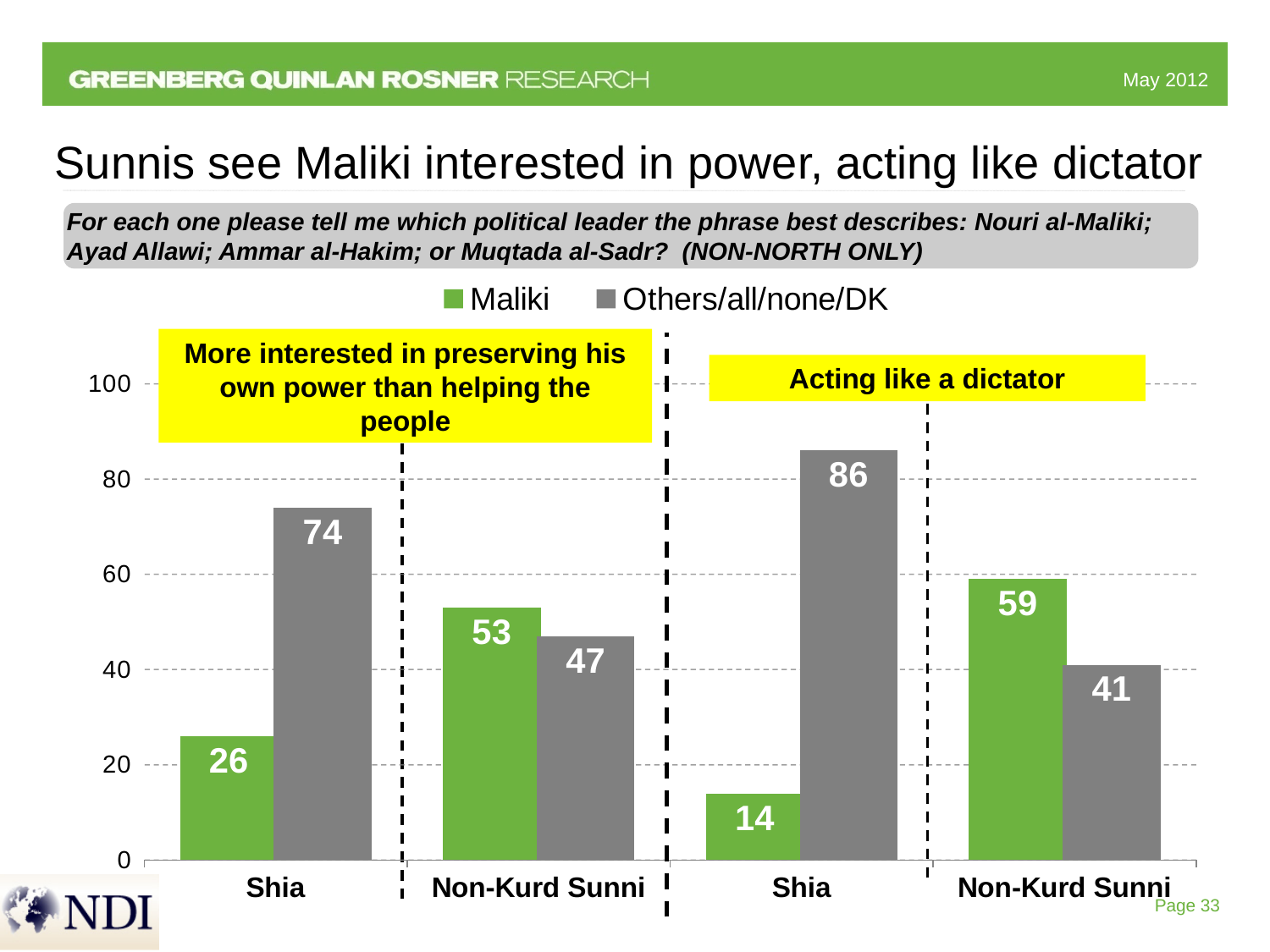
Across the whole chart, which bar has the lowest value? Maliki for Shia under 'Acting like a dictator' (14) In the 'More interested in preserving his own power than helping the people' section, what is the Maliki value for Shia? 26 Across the whole chart, which bar has the highest value? Others/all/none/DK for Shia under 'Acting like a dictator' (86) How many series does the legend list? 2 What kind of chart is shown on the slide? bar chart In the 'Acting like a dictator' section, which is larger for Non-Kurd Sunni: the Maliki value or the Others/all/none/DK value? Maliki In the 'More interested in preserving his own power than helping the people' section, what is the difference between the Maliki values for Non-Kurd Sunni and Shia? 27 In the 'Acting like a dictator' section, what is the difference between the Others/all/none/DK value and the Maliki value for Shia? 72 In the 'Acting like a dictator' section, what is the Others/all/none/DK value for Shia? 86 Which colour represents the Maliki series in the chart? green In the 'Acting like a dictator' section, what is the Maliki value for Non-Kurd Sunni? 59 In the 'More interested in preserving his own power than helping the people' section, what is the Others/all/none/DK value for Non-Kurd Sunni? 47